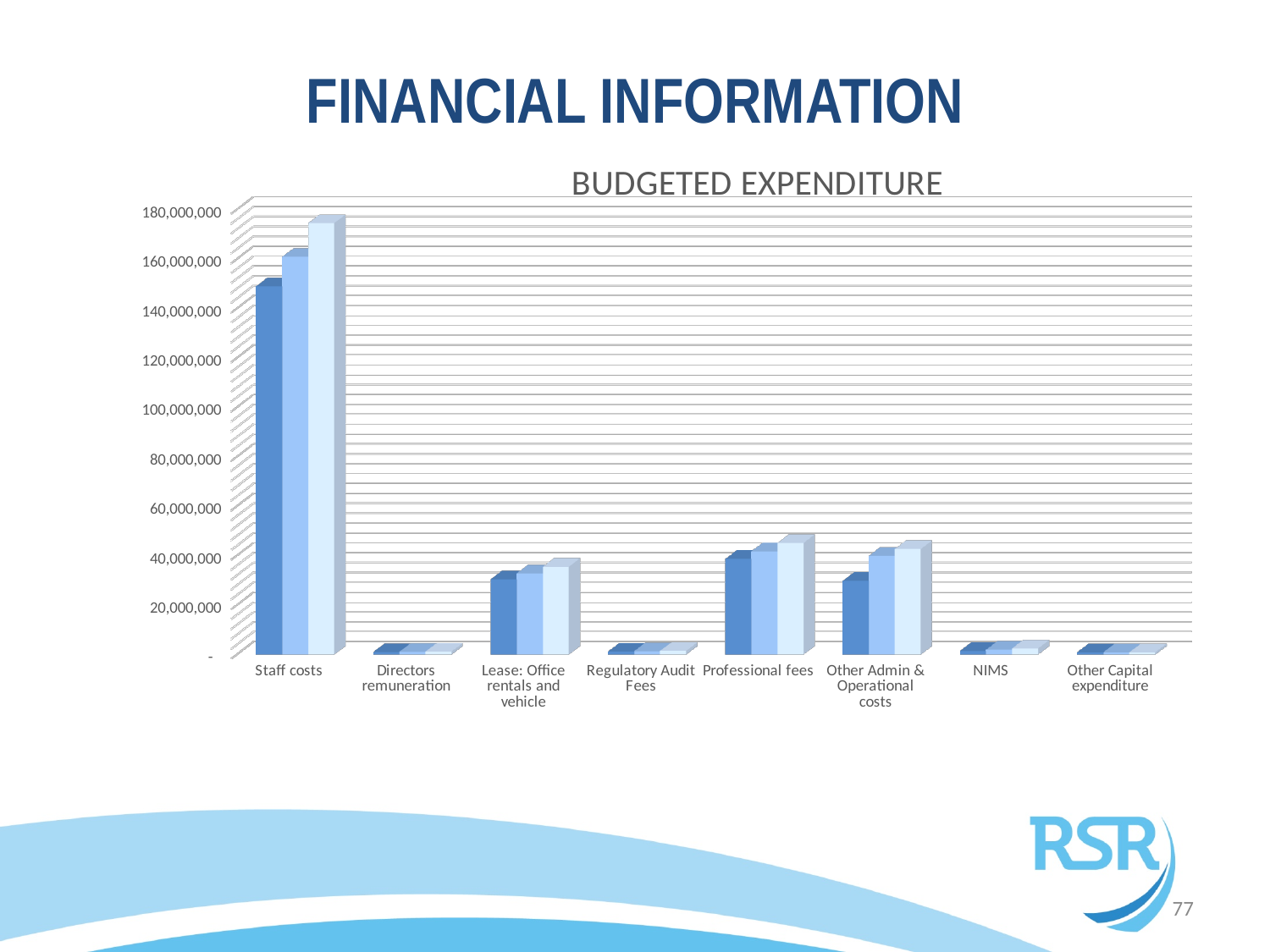
What kind of chart is shown on the slide? bar chart Is the value of the first (darkest) bar for Staff costs greater or less than 140,000,000? greater What is the title of the chart? BUDGETED EXPENDITURE Is the value for Directors remuneration greater or less than 20,000,000? less Which is larger, the budgeted expenditure for Staff costs or for Professional fees? Staff costs Is the value of the tallest bar for Staff costs greater or less than 160,000,000? greater Which category has the highest budgeted expenditure? Staff costs How many bars are plotted for each category? 3 Which is larger, the first bar for Professional fees or the first bar for Lease: Office rentals and vehicle? Professional fees How many expenditure categories are shown on the x axis? 8